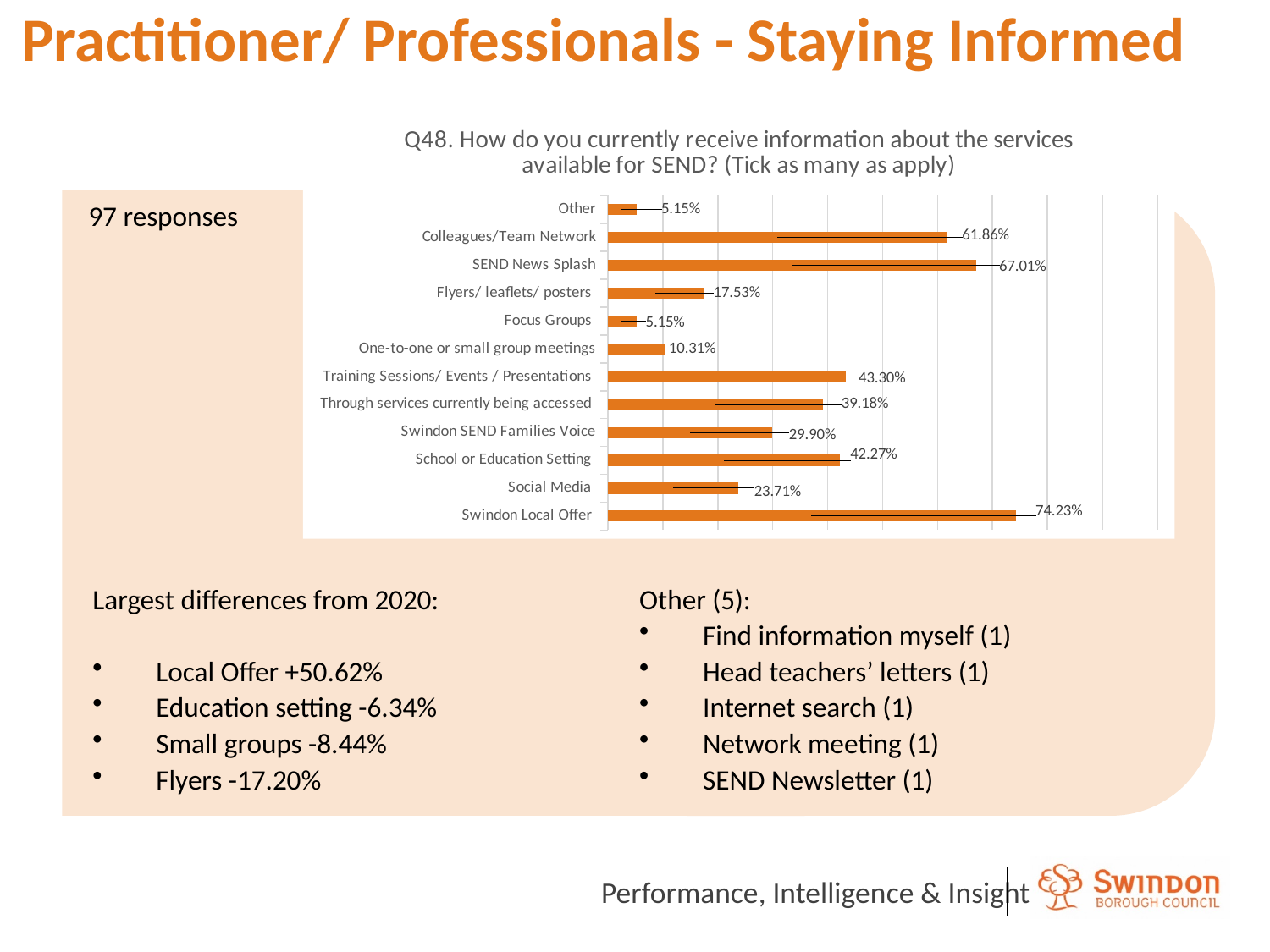
What percentage of respondents receive information through the Swindon Local Offer? 74.23% Which is larger, Training Sessions/ Events / Presentations or Through services currently being accessed? Training Sessions/ Events / Presentations What type of chart is shown on the slide? Bar chart Which category has the highest percentage? Swindon Local Offer What is the difference between Swindon Local Offer and SEND News Splash? 7.22% Which is larger, Swindon SEND Families Voice or One-to-one or small group meetings? Swindon SEND Families Voice What is the title of the chart? Q48. How do you currently receive information about the services available for SEND? (Tick as many as apply) What is the value for Flyers/ leaflets/ posters? 17.53% What is the difference between Colleagues/Team Network and Social Media? 38.15% What percentage is shown for Social Media? 23.71% How many categories are shown in the chart? 12 What is the value for SEND News Splash? 67.01%